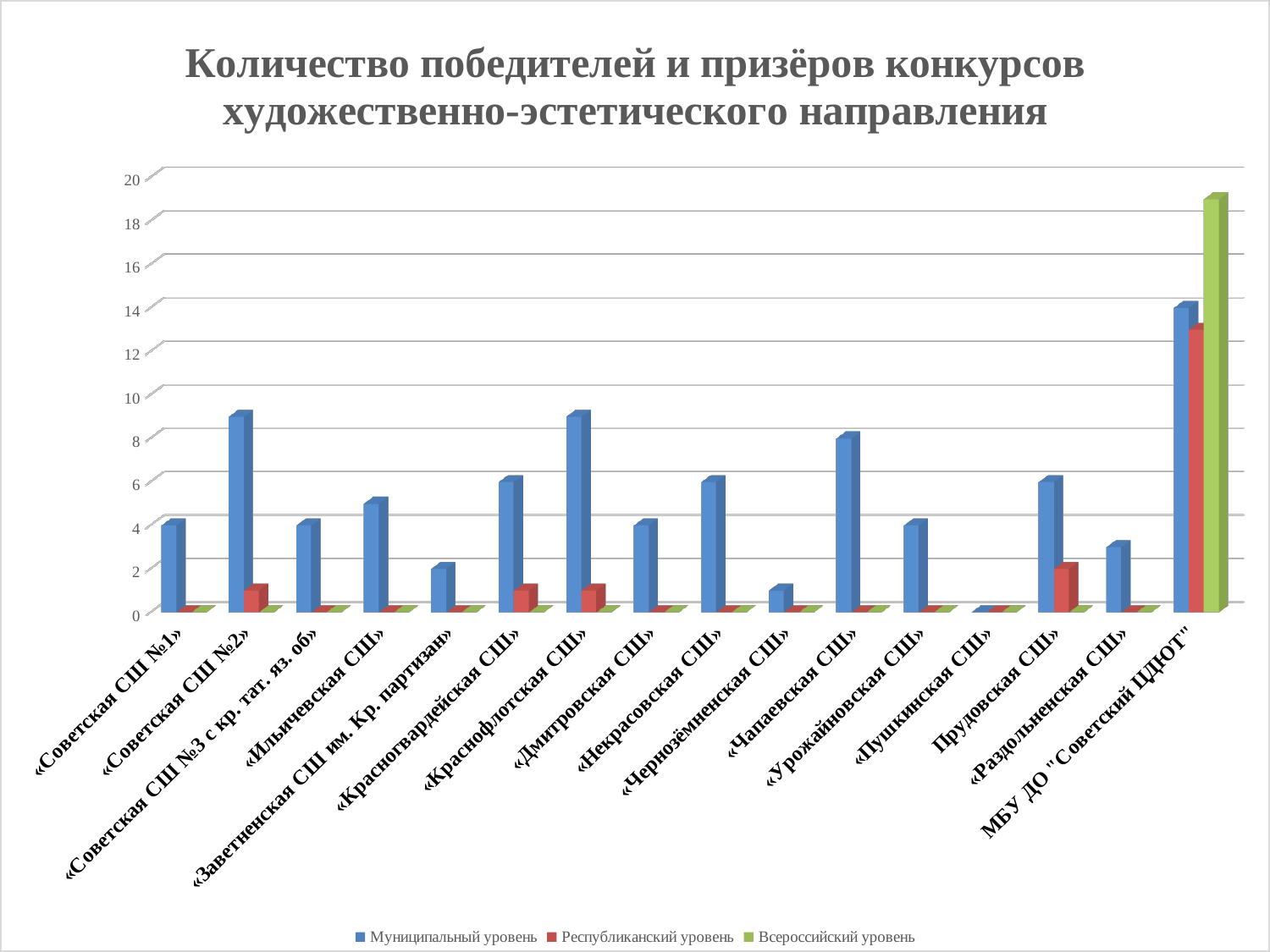
Which category has the tallest bar for Всероссийский уровень? МБУ ДО "Советский ЦДЮТ" Is the Муниципальный уровень value for «Заветненская СШ им. Кр. партизан» greater or less than 4? less Which category has the lowest value for Муниципальный уровень? «Пушкинская СШ» Is the Всероссийский уровень value for МБУ ДО "Советский ЦДЮТ" greater or less than 16? greater How many series does the legend list? 3 How many schools (categories) are shown on the x axis? 16 Which has the larger Муниципальный уровень value: «Советская СШ №1» or «Советская СШ №2»? «Советская СШ №2» Is the Республиканский уровень value for «Прудовская СШ» greater or less than 4? less Which category has the highest value for Муниципальный уровень? МБУ ДО "Советский ЦДЮТ" Which series is shown in green in the legend? Всероссийский уровень What kind of chart is shown on the slide? bar chart